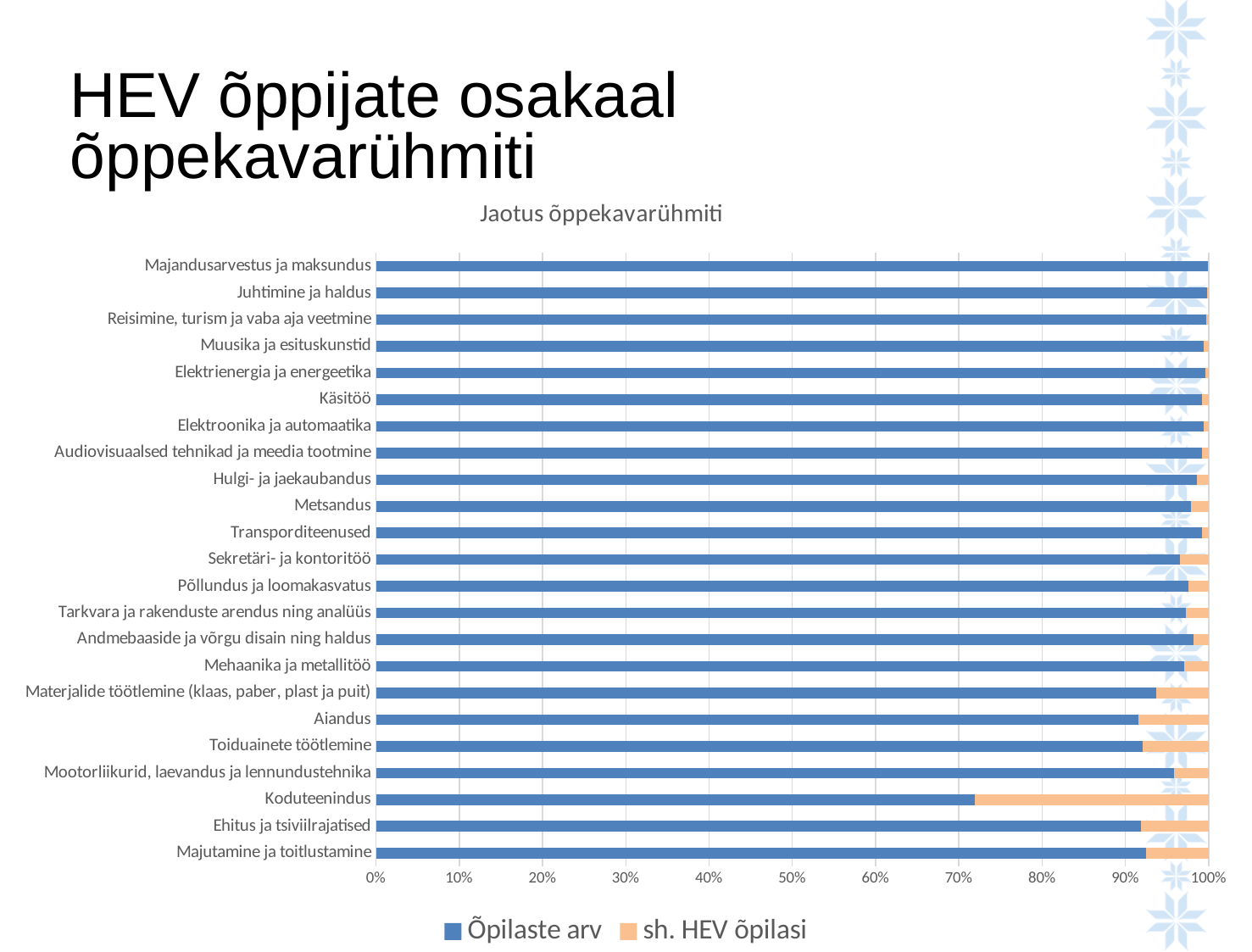
Which category has the largest share of 'sh. HEV õpilasi'? Koduteenindus Is the 'Õpilaste arv' share for Majandusarvestus ja maksundus greater or less than 90%? greater Which has a larger 'sh. HEV õpilasi' share, Koduteenindus or Majandusarvestus ja maksundus? Koduteenindus How many series does the legend list? 2 What kind of chart is shown on the slide? Stacked bar chart What is the title of the chart? Jaotus õppekavarühmiti How many categories (õppekavarühmad) are plotted on the chart? 23 Which series is shown in orange in the legend? sh. HEV õpilasi Is the 'Õpilaste arv' share for Koduteenindus greater or less than 80%? less Is the 'Õpilaste arv' share for Koduteenindus greater or less than 70%? greater Which has a larger 'Õpilaste arv' share, Koduteenindus or Aiandus? Aiandus Which category has the smallest share of 'Õpilaste arv'? Koduteenindus